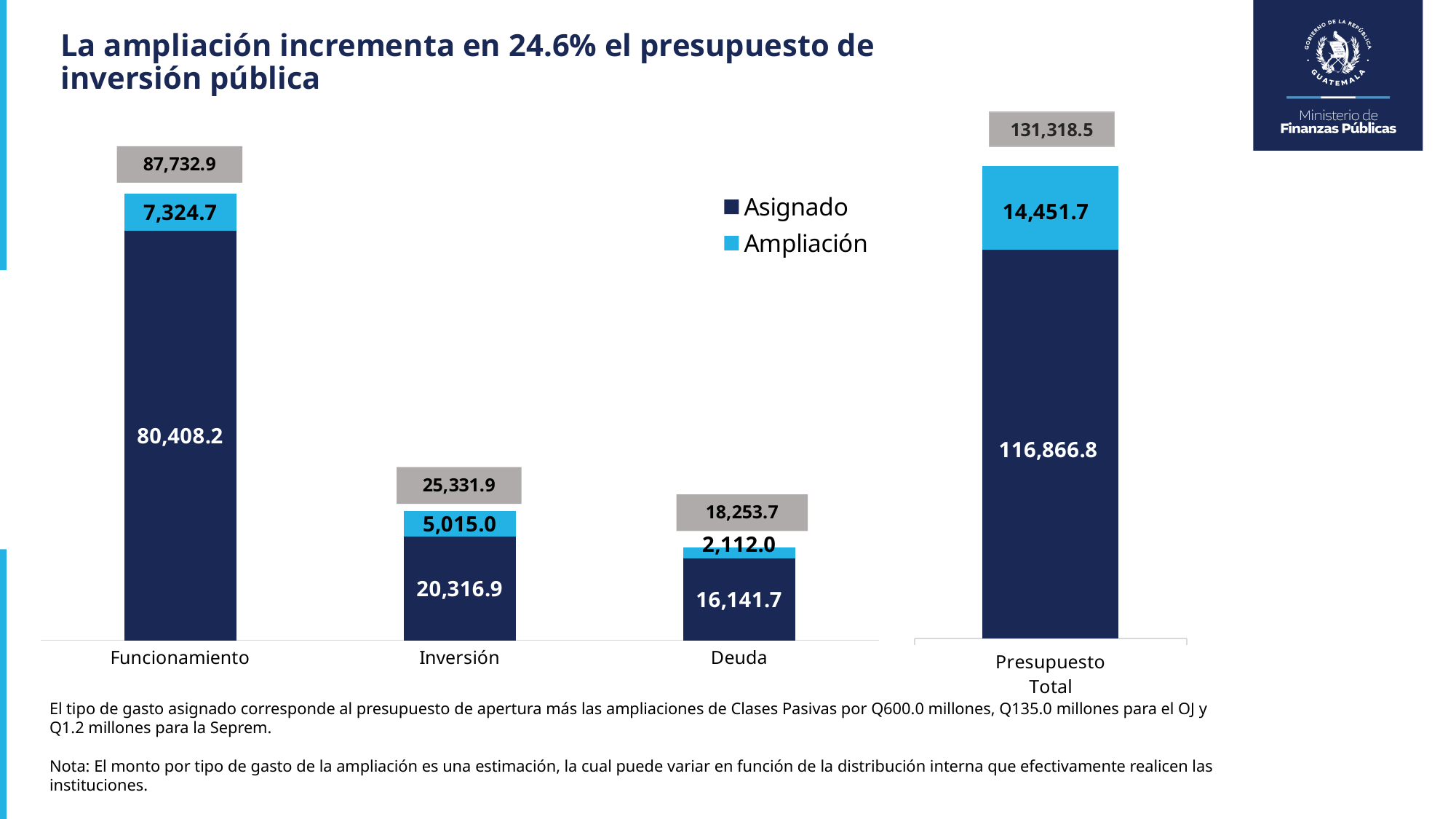
What is the total of the stacked bar for Inversión? 25,331.9 What is the difference between the Ampliación values for Funcionamiento and Inversión? 2,309.7 Which is larger, the Asignado value for Inversión or the Asignado value for Deuda? Inversión What is the Asignado value for Funcionamiento? 80,408.2 Among Funcionamiento, Inversión and Deuda, which category has the lowest Ampliación value? Deuda What is the total of the stacked bar for Presupuesto Total? 131,318.5 What is the Asignado value for Presupuesto Total? 116,866.8 How many series does the legend list? 2 What kind of chart is shown on the slide? Stacked bar chart What is the Ampliación value for Deuda? 2,112.0 What is the Ampliación value for Inversión? 5,015.0 Among Funcionamiento, Inversión and Deuda, which category has the highest Asignado value? Funcionamiento